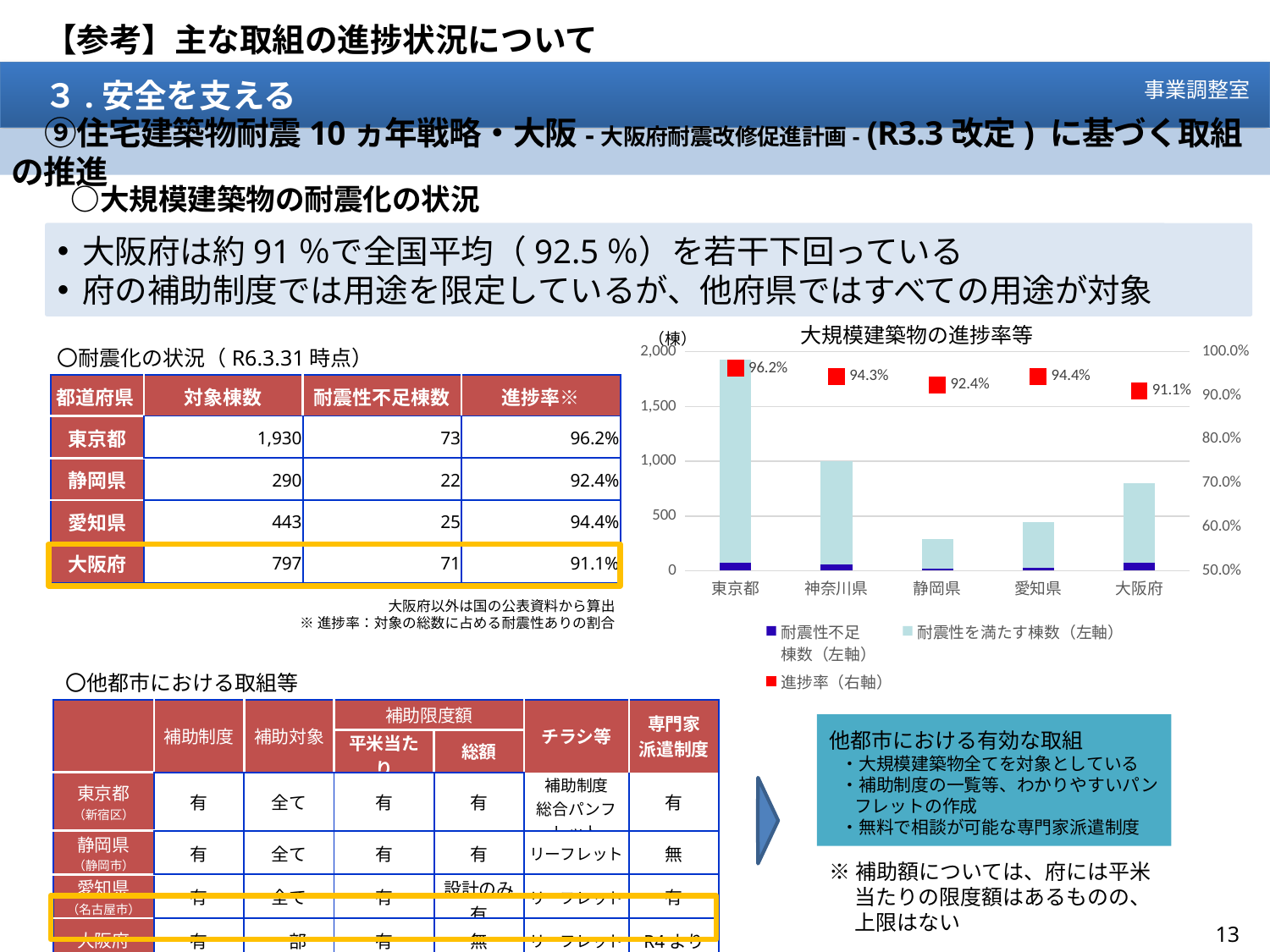
In the chart 大規模建築物の進捗率等, is the total bar height for 神奈川県 greater or less than 500 棟? greater In the chart 大規模建築物の進捗率等, what is the 進捗率 value shown for 大阪府? 91.1% In the chart 大規模建築物の進捗率等, which prefecture has the highest 進捗率? 東京都 How many prefectures are shown on the x axis of the chart 大規模建築物の進捗率等? 5 How many series does the legend of the chart 大規模建築物の進捗率等 list? 3 In the chart 大規模建築物の進捗率等, what is the 進捗率 value shown for 神奈川県? 94.3% In the chart 大規模建築物の進捗率等, is the total bar height for 静岡県 greater or less than 500 棟? less In the chart 大規模建築物の進捗率等, what is the 進捗率 value shown for 東京都? 96.2% In the chart 大規模建築物の進捗率等, what is the difference between the 進捗率 of 東京都 and 大阪府? 5.1 percentage points What kind of chart is the chart titled 大規模建築物の進捗率等? bar chart In the chart 大規模建築物の進捗率等, which has a higher 進捗率, 静岡県 or 愛知県? 愛知県 In the chart 大規模建築物の進捗率等, which prefecture has the lowest 進捗率? 大阪府